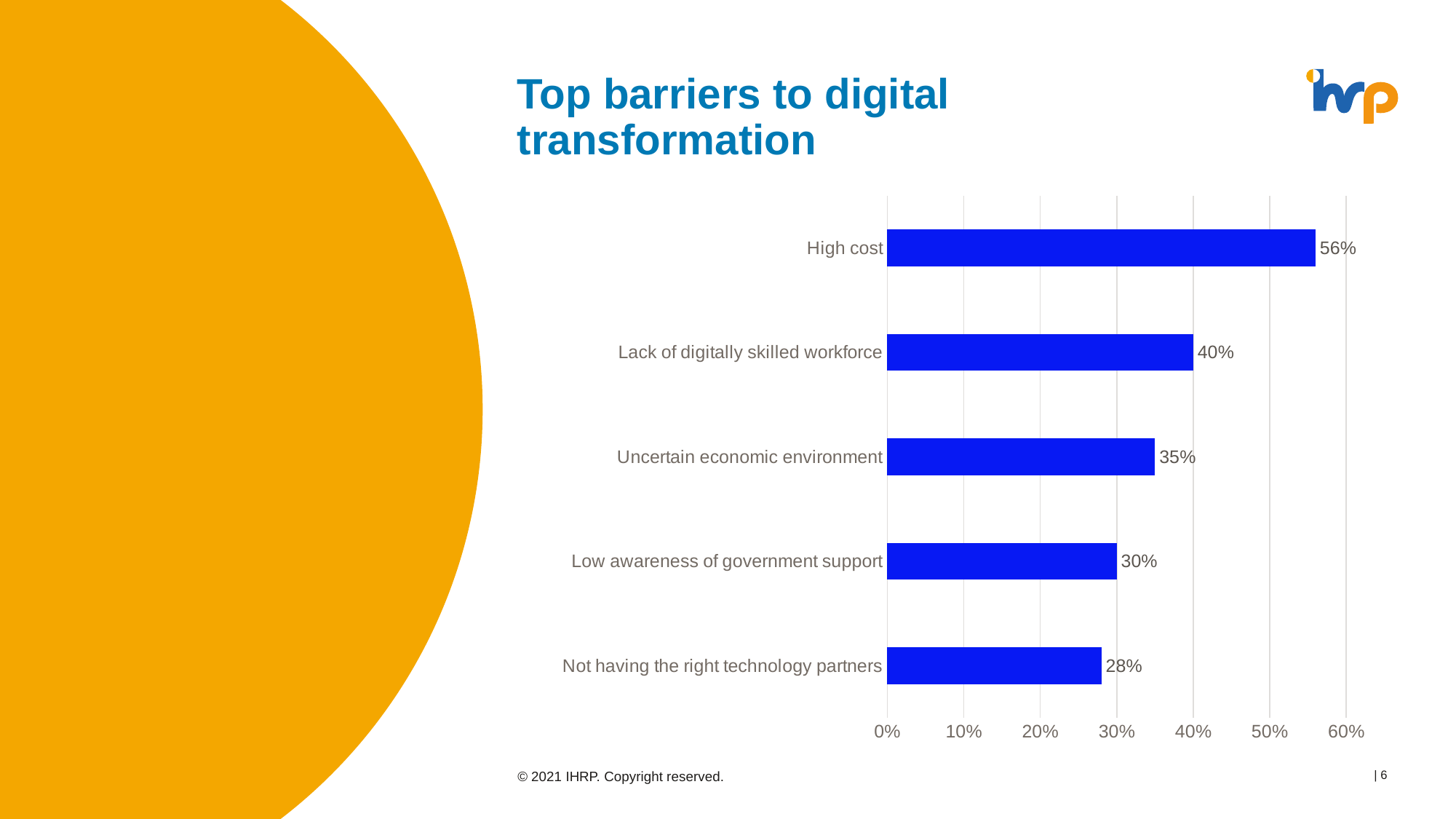
What is the title of the slide containing the chart? Top barriers to digital transformation What is the value for Lack of digitally skilled workforce? 40% What is the value for Not having the right technology partners? 28% What percentage is shown for Uncertain economic environment? 35% Which is larger: Uncertain economic environment or Low awareness of government support? Uncertain economic environment What kind of chart is shown on the slide? Bar chart What percentage is shown for High cost? 56% What is the difference between Low awareness of government support and Not having the right technology partners? 2% What is the difference between High cost and Lack of digitally skilled workforce? 16% Which barrier has the highest percentage? High cost How many barriers are shown in the chart? 5 Which barrier has the lowest percentage? Not having the right technology partners